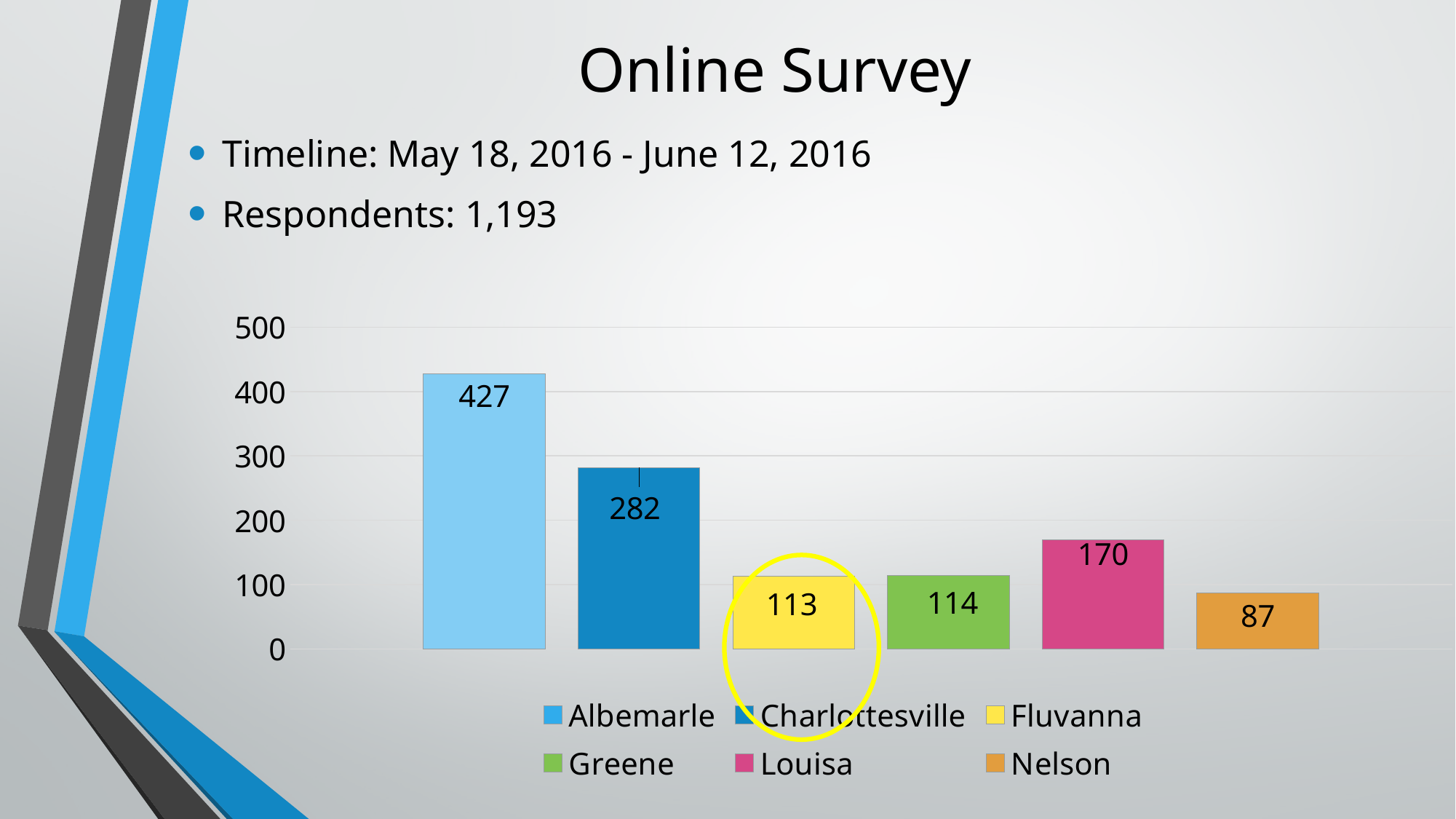
What is the value for Albemarle? 427 How many categories are shown in the chart? 6 What is the difference between the values for Louisa and Nelson? 83 What is the difference between the values for Albemarle and Charlottesville? 145 What kind of chart is shown on the slide? Bar chart Which category has the lowest value? Nelson What is the value for Nelson? 87 What is the value for Fluvanna? 113 Which category's bar is circled in yellow on the chart? Fluvanna What is the value for Charlottesville? 282 Which is larger, the value for Louisa or the value for Greene? Louisa Which category has the highest value? Albemarle